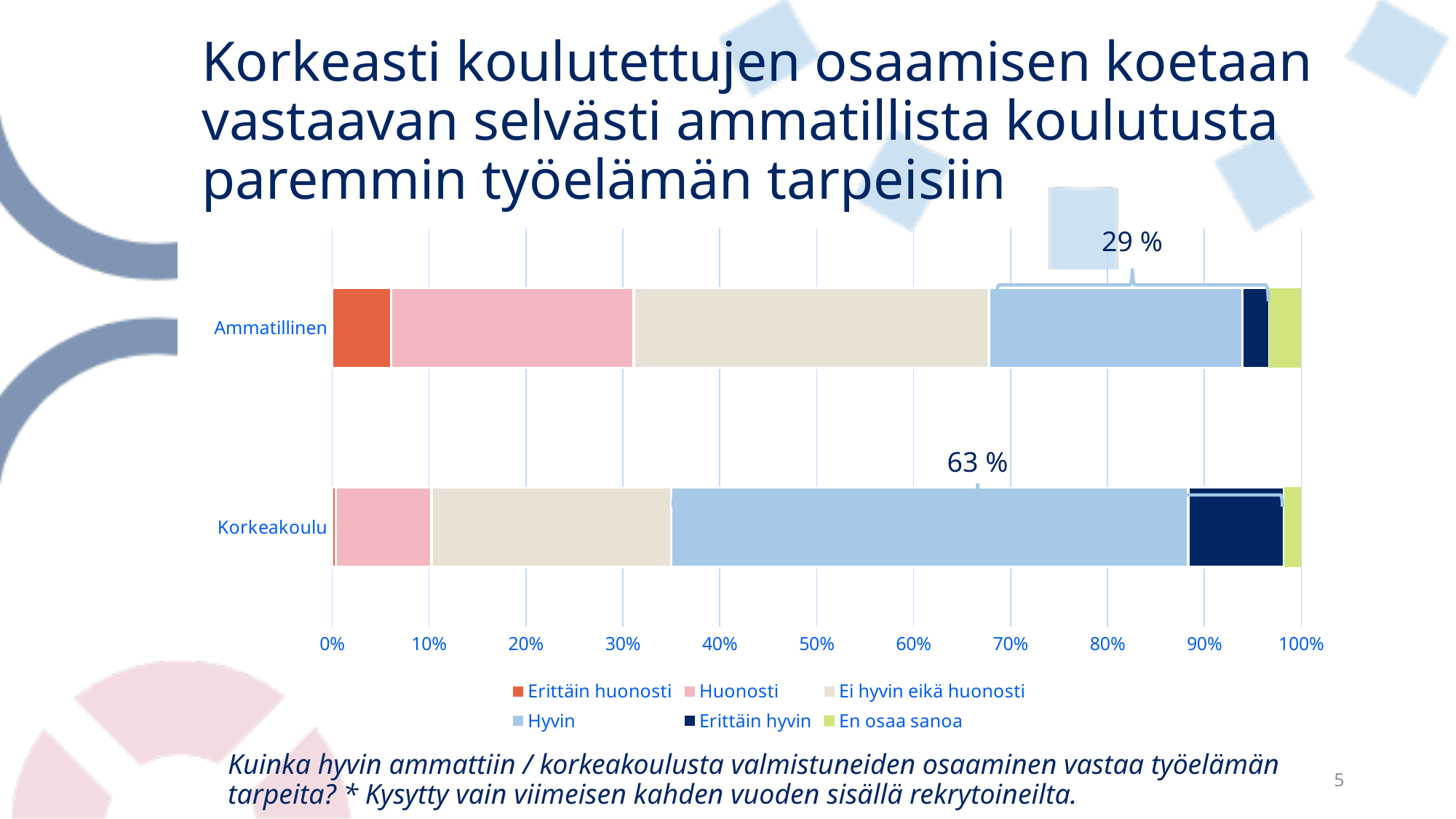
What kind of chart is shown on the slide? Stacked bar chart Which legend entry is shown in dark navy blue? Erittäin hyvin Which category has the larger 'Erittäin huonosti' segment, Ammatillinen or Korkeakoulu? Ammatillinen What percentage is annotated above the Korkeakoulu bar? 63 % Which category has the larger 'Hyvin' segment, Ammatillinen or Korkeakoulu? Korkeakoulu Is the 'Erittäin huonosti' segment for Ammatillinen greater or less than 10%? less What percentage is annotated above the Ammatillinen bar? 29 % How many categories (bars) does the chart show? 2 What is the difference between the annotated percentages for Korkeakoulu (63 %) and Ammatillinen (29 %)? 34 percentage points Is the 'Hyvin' segment for Korkeakoulu greater or less than 50%? greater Which category has the larger annotated percentage, Ammatillinen or Korkeakoulu? Korkeakoulu How many series does the legend list? 6